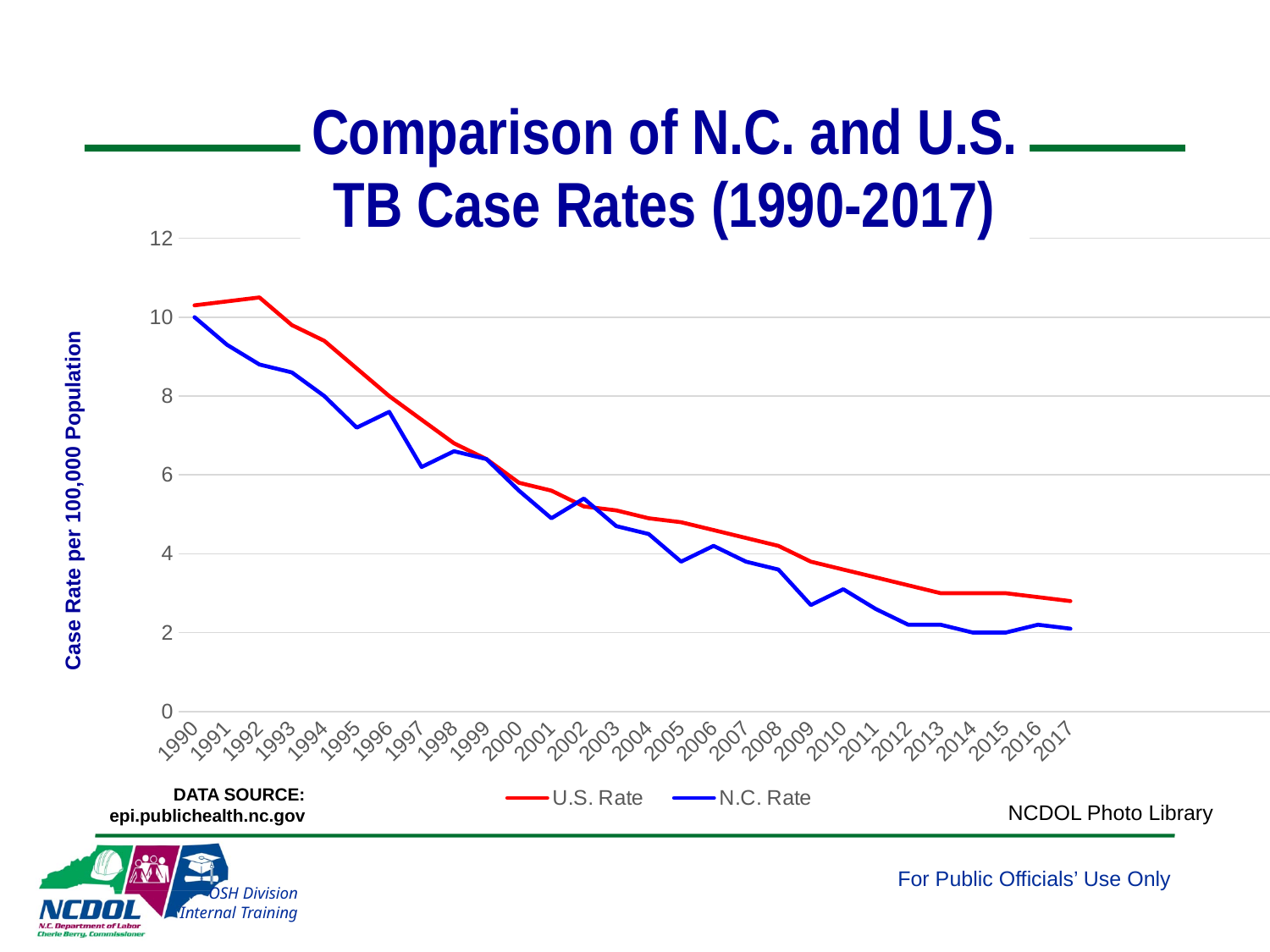
Is the N.C. Rate for 2009 greater or less than 4? less In 1990, which is higher, the U.S. Rate or the N.C. Rate? U.S. Rate In 2017, which is higher, the U.S. Rate or the N.C. Rate? U.S. Rate What kind of chart is shown on the slide? line chart Do the U.S. Rate values generally rise or fall from 1990 to 2017? fall Is the N.C. Rate for 1996 greater or less than 8? less How many years are plotted along the x axis? 28 Is the U.S. Rate for 1992 greater or less than 10? greater What is the label on the vertical axis of the chart? Case Rate per 100,000 Population How many series does the legend list? 2 Do the N.C. Rate values generally rise or fall from 1990 to 2017? fall